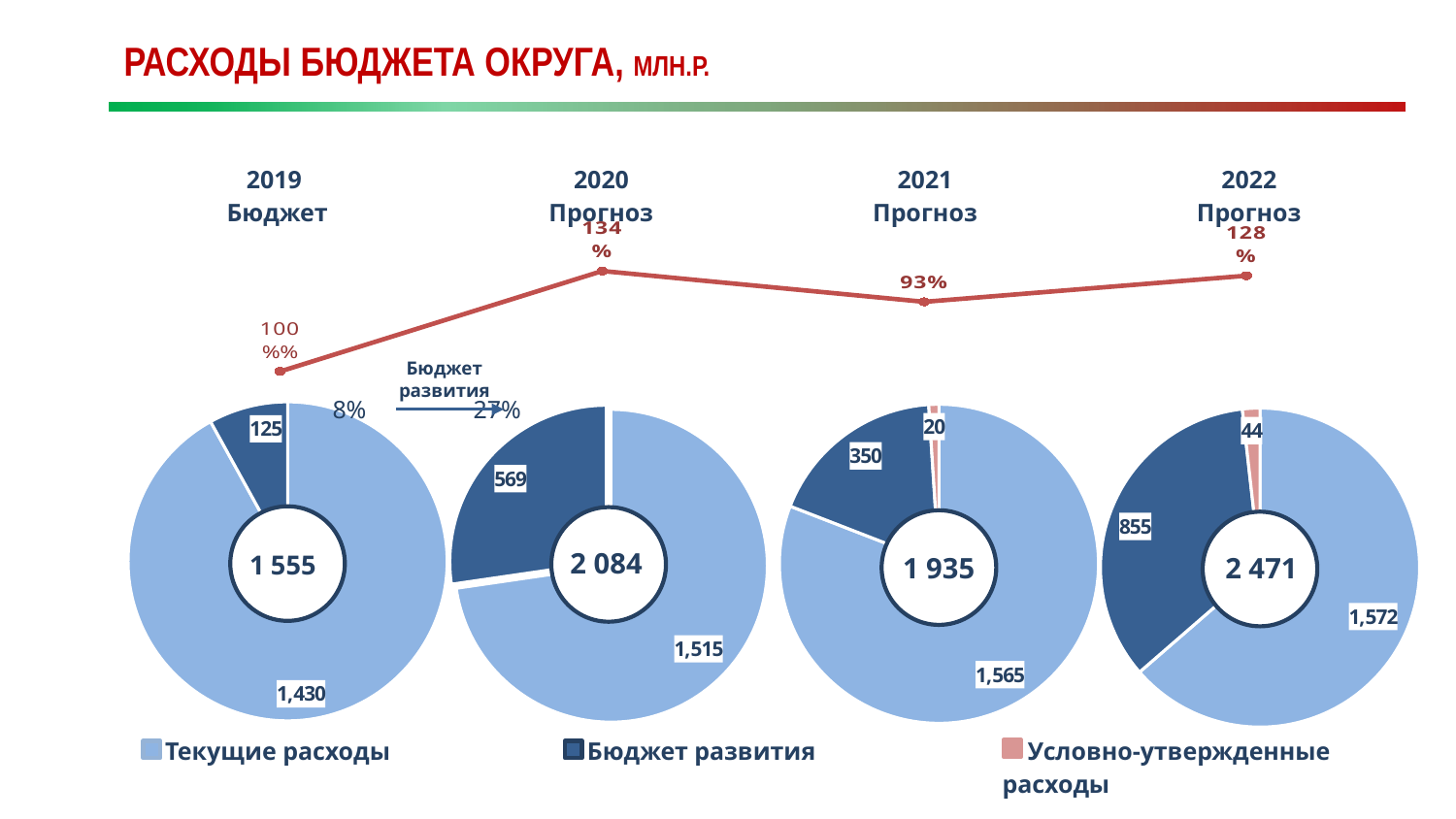
How many donut charts are shown on the slide? 4 What is the difference between Бюджет развития in the 2020 Прогноз donut chart and in the 2019 Бюджет donut chart? 444 On the line chart above the donuts, which year has the lowest percentage? 2021 Прогноз In the 2021 Прогноз donut chart, what is the value for Условно-утвержденные расходы? 20 On the line chart above the donuts, what percentage is shown for 2020 Прогноз? 134% In the 2020 Прогноз donut chart, what is the value for Бюджет развития? 569 In the 2019 Бюджет donut chart, what is the value for Текущие расходы? 1,430 In the 2022 Прогноз donut chart, what is the value for Бюджет развития? 855 In the 2022 Прогноз donut chart, which is larger: Текущие расходы or Бюджет развития? Текущие расходы What total is shown in the centre of the 2022 Прогноз donut chart? 2 471 How many series does the legend at the bottom of the slide list? 3 What kind of chart is used for each year's breakdown of expenses? Donut (pie) chart